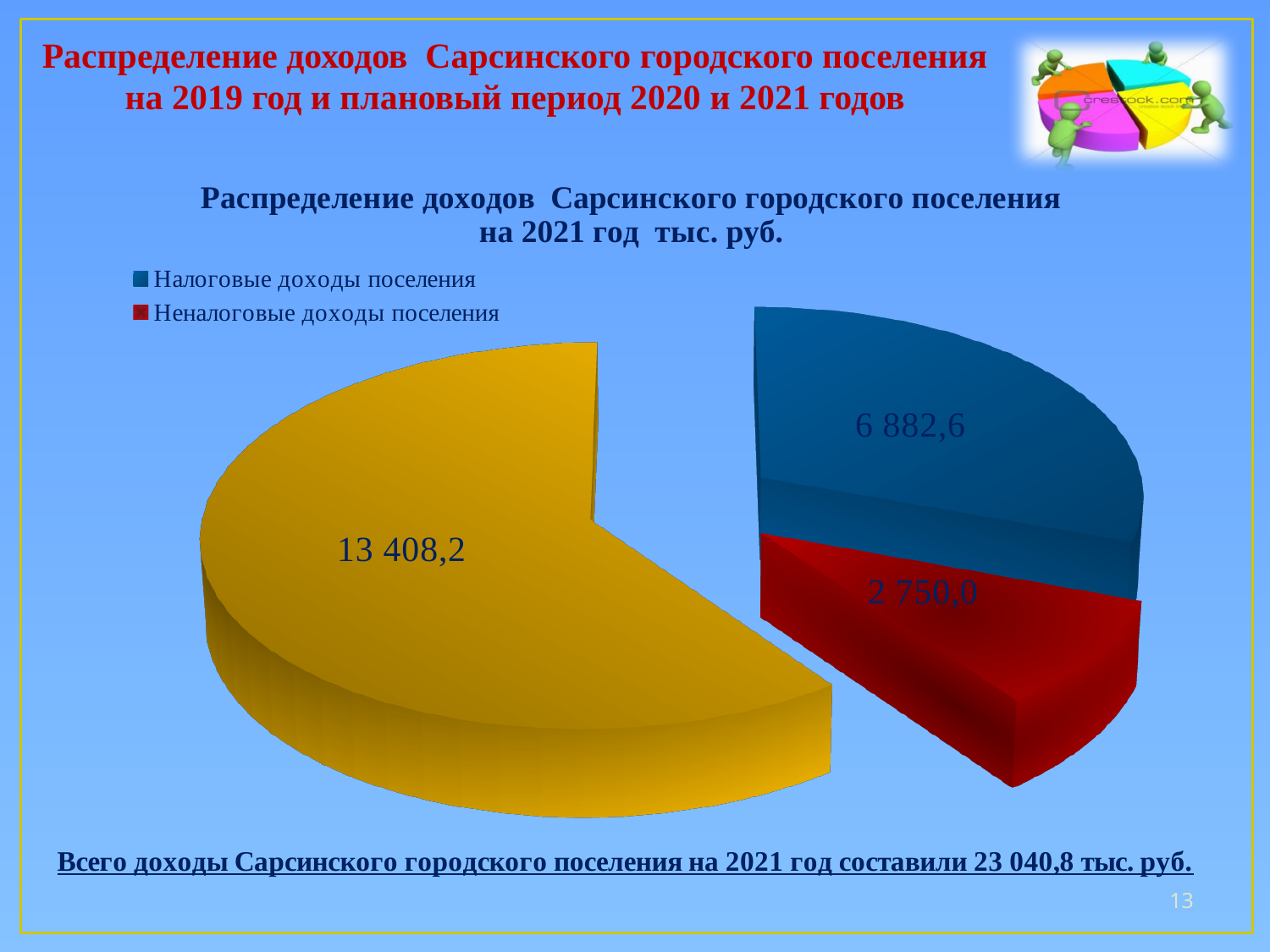
Which of the two legend categories has the smallest slice in the pie chart? Неналоговые доходы поселения What value is printed on the yellow slice of the pie chart? 13 408,2 Which slice of the pie chart is the largest? the yellow slice (13 408,2) What is the difference between Налоговые доходы поселения and Неналоговые доходы поселения? 4 132,6 How many entries does the legend of the pie chart list? 2 What is the value for Неналоговые доходы поселения in the pie chart? 2 750,0 What kind of chart is shown on the slide? pie chart Which is larger, Налоговые доходы поселения or Неналоговые доходы поселения? Налоговые доходы поселения How many slices does the pie chart have? 3 What colour represents Налоговые доходы поселения in the pie chart? blue What is the value for Налоговые доходы поселения in the pie chart? 6 882,6 By how much does the yellow slice (13 408,2) exceed Налоговые доходы поселения (6 882,6)? 6 525,6